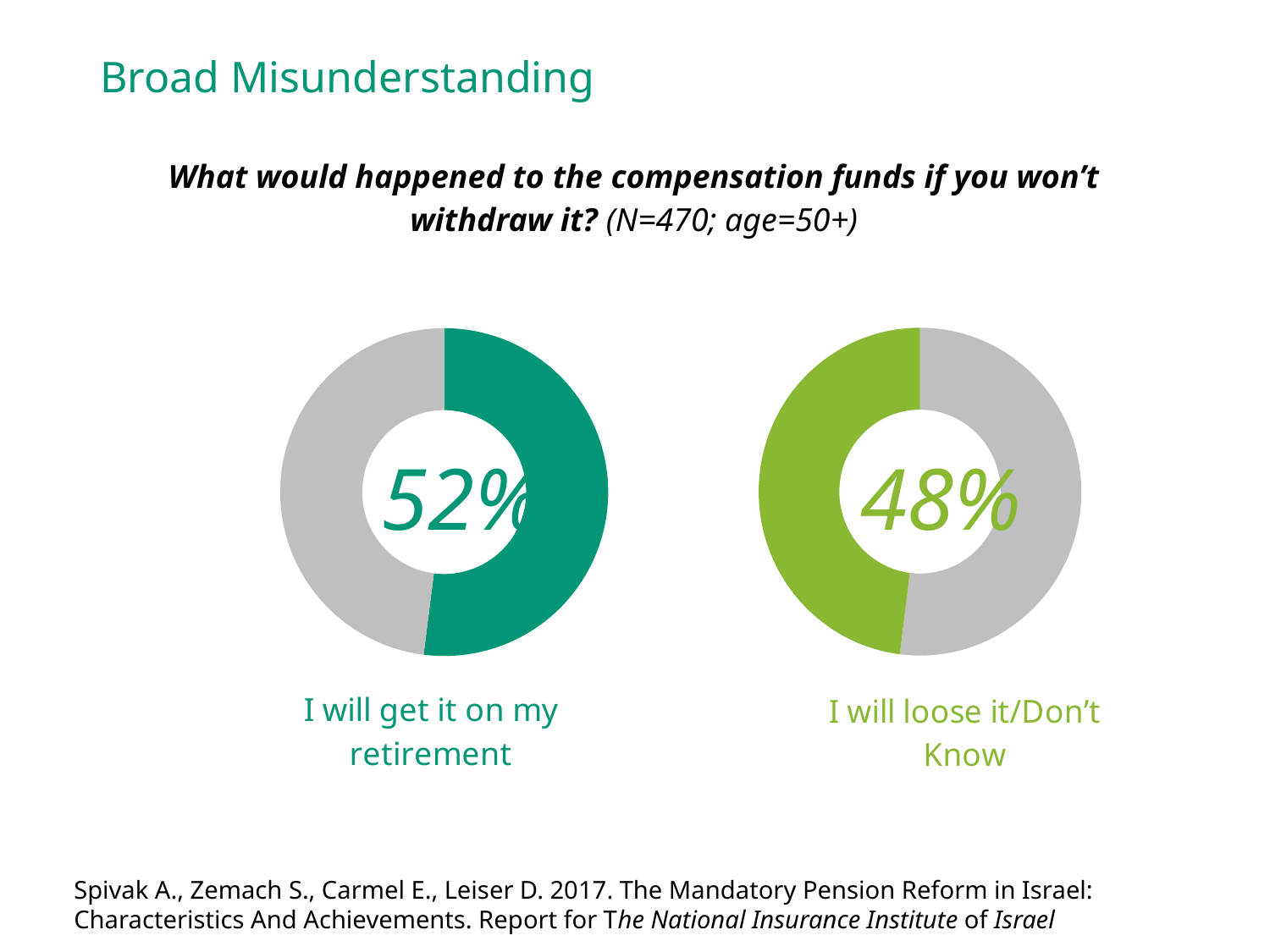
What percentage of respondents said "I will loose it/Don't Know"? 48% What percentage of respondents said "I will get it on my retirement"? 52% What kind of chart is used to show the 52% and 48% values on the slide? Donut (pie) chart What is the sample size (N) stated for the survey question on the slide? 470 Is the share for "I will get it on my retirement" greater or less than 50%? greater What is the total of the two percentages shown in the donut charts? 100% Which response has the larger share: "I will get it on my retirement" or "I will loose it/Don't Know"? I will get it on my retirement What is the difference in percentage points between the "I will get it on my retirement" share and the "I will loose it/Don't Know" share? 4 percentage points How many donut charts are shown on the slide? 2 Is the share for "I will loose it/Don't Know" greater or less than 50%? less What colour is the highlighted segment of the left donut chart ("I will get it on my retirement")? Teal green